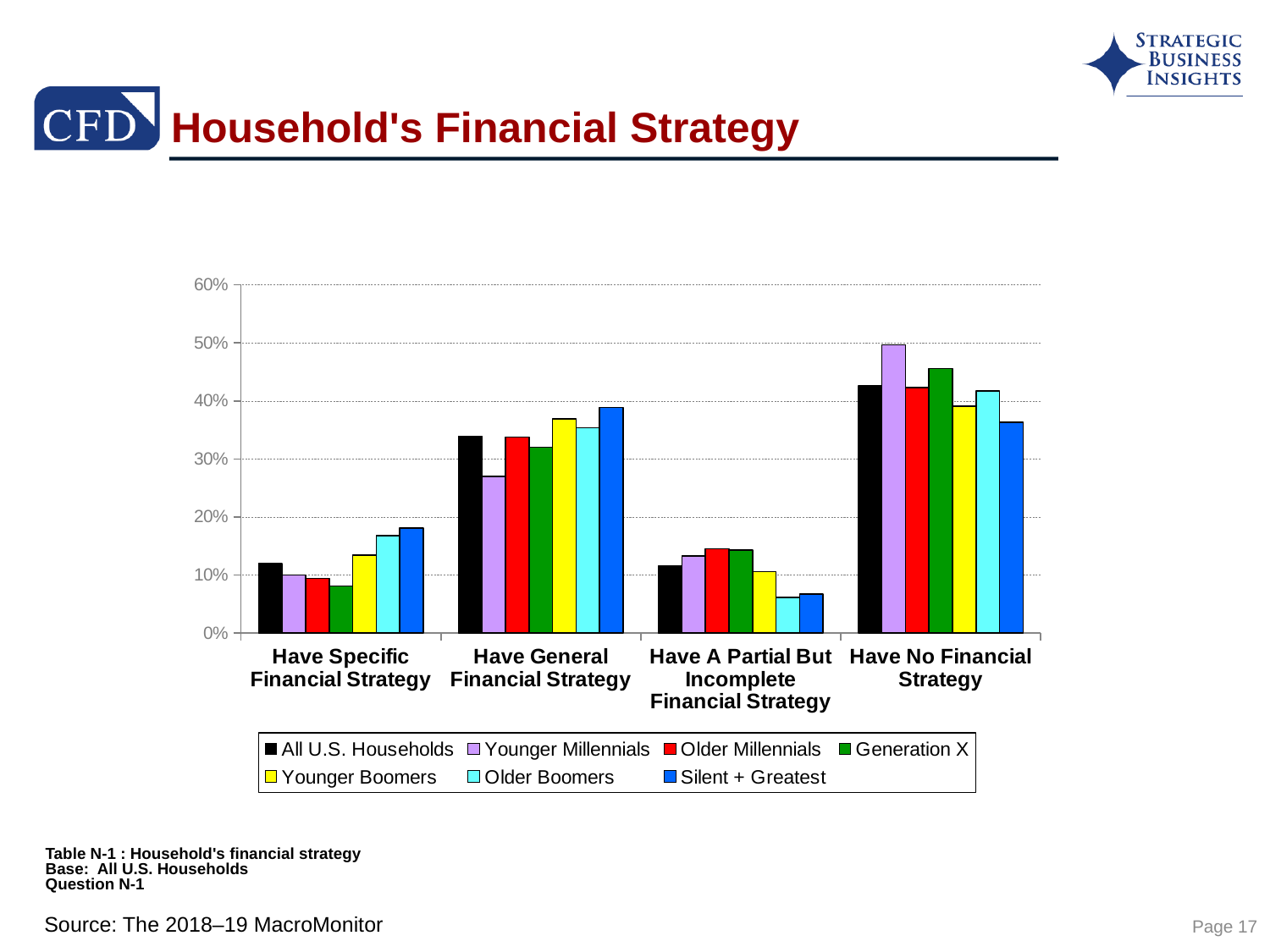
How many financial strategy categories are shown on the x axis? 4 In the 'Have General Financial Strategy' category, which series has the highest value? Silent + Greatest In 'Have General Financial Strategy', which is larger: Silent + Greatest or Younger Millennials? Silent + Greatest Is the value for Younger Millennials in 'Have General Financial Strategy' greater or less than 30%? less In the 'Have No Financial Strategy' category, which series has the highest value? Younger Millennials In 'Have A Partial But Incomplete Financial Strategy', which is larger: Older Boomers or Older Millennials? Older Millennials In the 'Have Specific Financial Strategy' category, which series has the lowest value? Generation X Is the value for All U.S. Households in 'Have Specific Financial Strategy' greater or less than 10%? greater How many series does the legend list? 7 Is the value for Silent + Greatest in 'Have No Financial Strategy' greater or less than 40%? less What is the title of the chart on the slide? Household's Financial Strategy What kind of chart is shown on the slide? bar chart